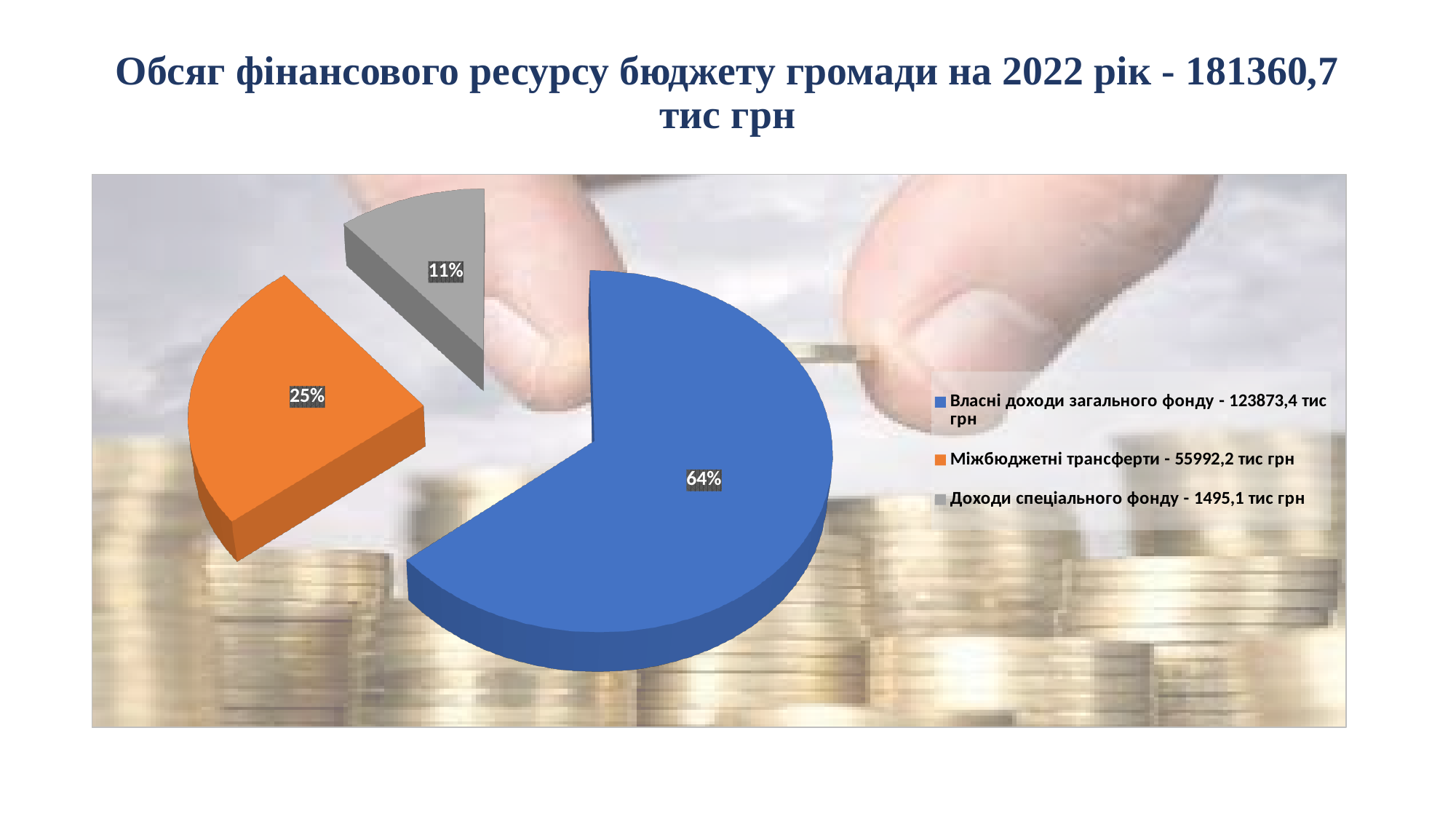
What is the difference in percentage points between the Власні доходи загального фонду slice and the Міжбюджетні трансферти slice? 39 What kind of chart is shown on the slide? Pie chart Which category has the smallest slice of the pie? Доходи спеціального фонду According to the legend, what amount is given for Власні доходи загального фонду? 123873,4 тис грн How many slices does the pie chart have? 3 Which category has the largest slice of the pie? Власні доходи загального фонду What percentage share is shown for Власні доходи загального фонду? 64% Which slice is larger: Міжбюджетні трансферти or Доходи спеціального фонду? Міжбюджетні трансферти What percentage share is shown for Доходи спеціального фонду? 11% What colour is the slice for Доходи спеціального фонду? Grey According to the legend, what amount is given for Міжбюджетні трансферти? 55992,2 тис грн What percentage share is shown for Міжбюджетні трансферти? 25%